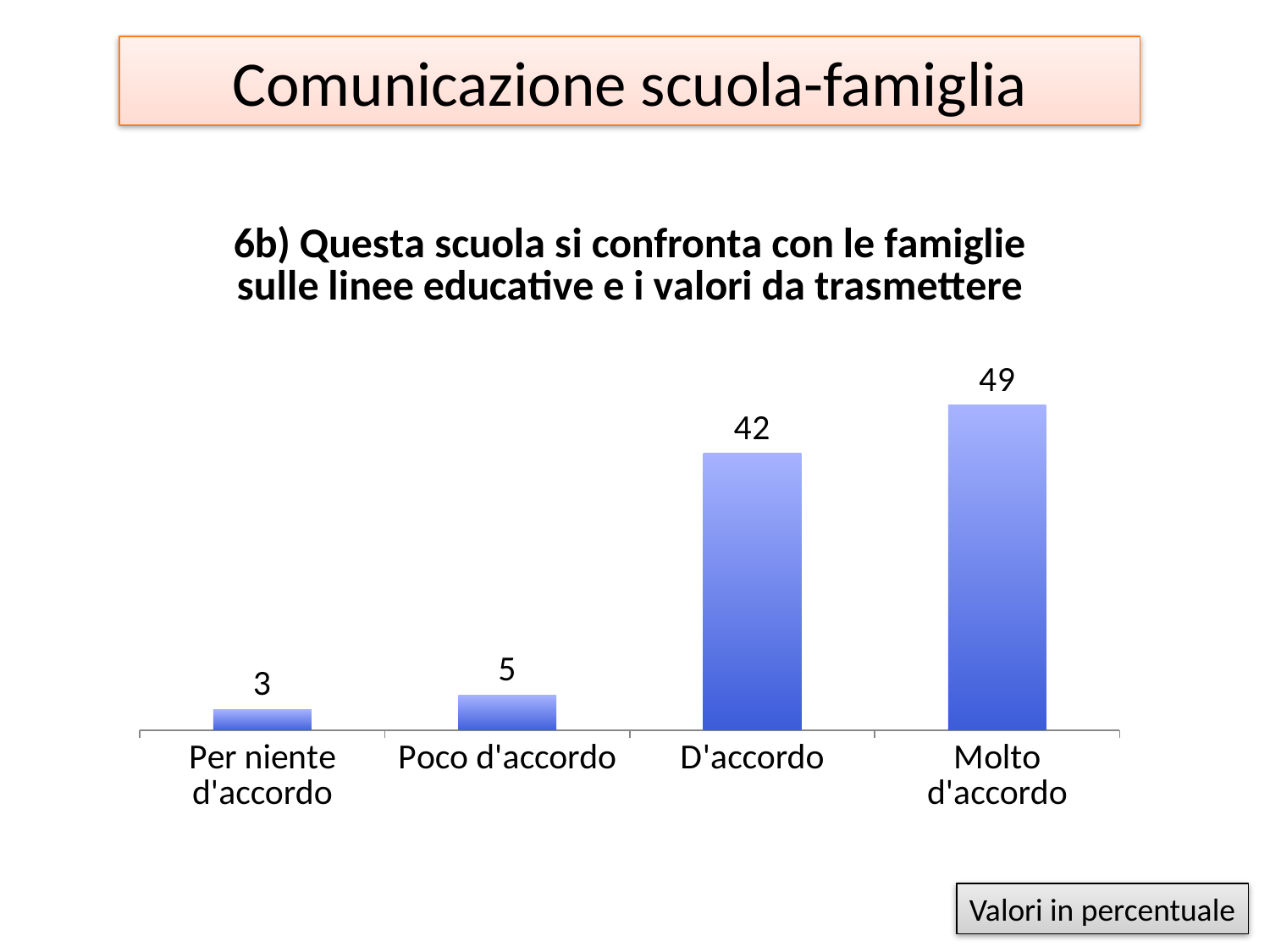
What is the value for "D'accordo"? 42 What is the value for "Poco d'accordo"? 5 What is the difference between the values for "Poco d'accordo" and "Per niente d'accordo"? 2 What is the value for "Molto d'accordo"? 49 What kind of chart is shown on the slide? Bar chart Which is larger, the value for "D'accordo" or the value for "Poco d'accordo"? D'accordo Do the values rise or fall from left to right along the x axis? Rise How many categories are shown on the x axis? 4 What is the difference between the values for "Molto d'accordo" and "D'accordo"? 7 Which category has the highest value? Molto d'accordo Which category has the lowest value? Per niente d'accordo What is the value for "Per niente d'accordo"? 3